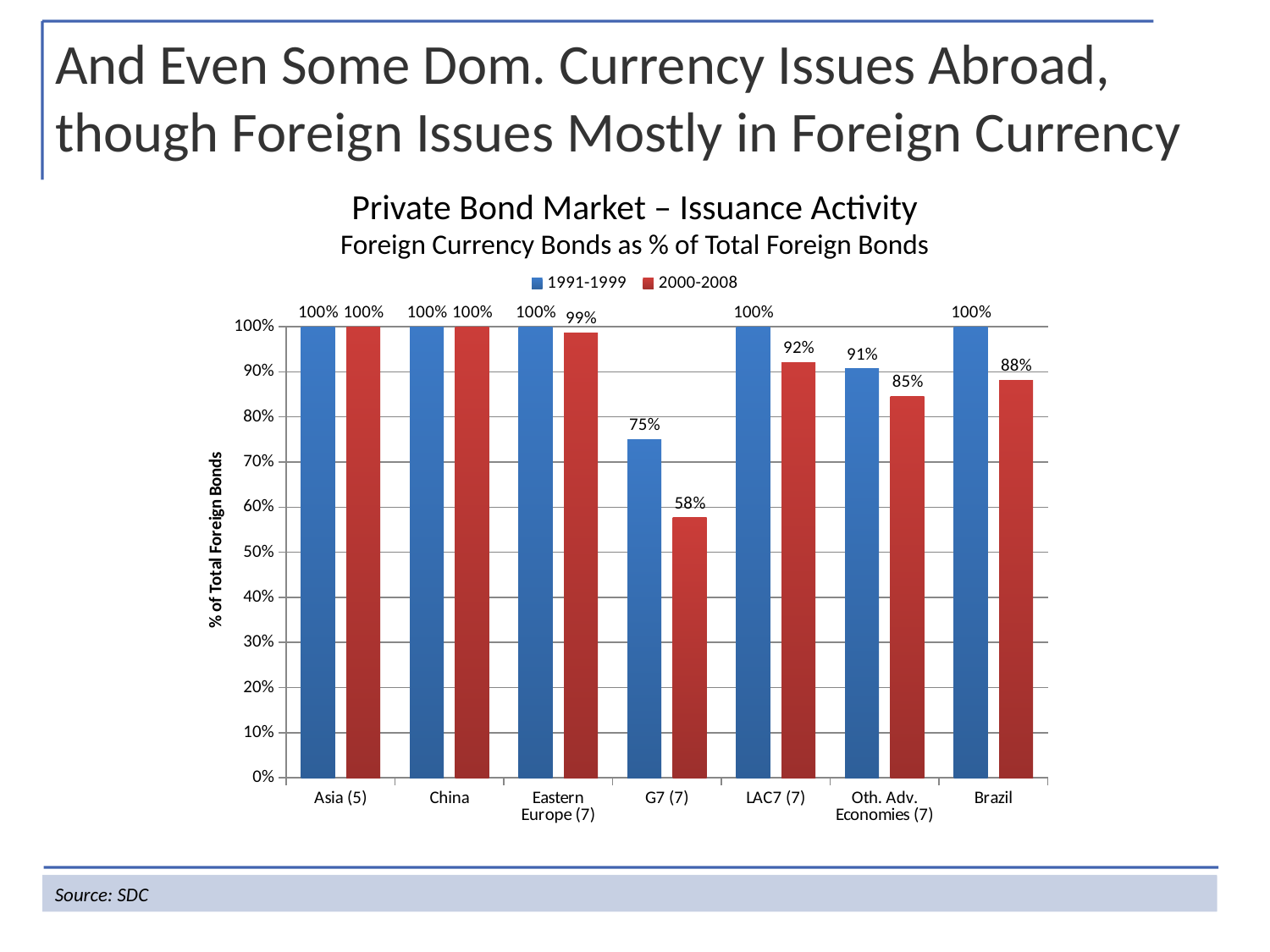
What kind of chart is shown on the slide? Bar chart What is the difference between the 1991-1999 and 2000-2008 values for G7 (7)? 17% Which category has the lowest value in the 1991-1999 series? G7 (7) How many series does the legend list? 2 What is the value for Eastern Europe (7) in the 2000-2008 series? 99% What is the value for Brazil in the 2000-2008 series? 88% How many categories are shown on the x axis? 7 What is the value for G7 (7) in the 2000-2008 series? 58% What is the difference between the 1991-1999 and 2000-2008 values for Brazil? 12% Which category has the lowest value in the 2000-2008 series? G7 (7) Which is larger for LAC7 (7): the 1991-1999 value or the 2000-2008 value? 1991-1999 What is the value for Oth. Adv. Economies (7) in the 1991-1999 series? 91%